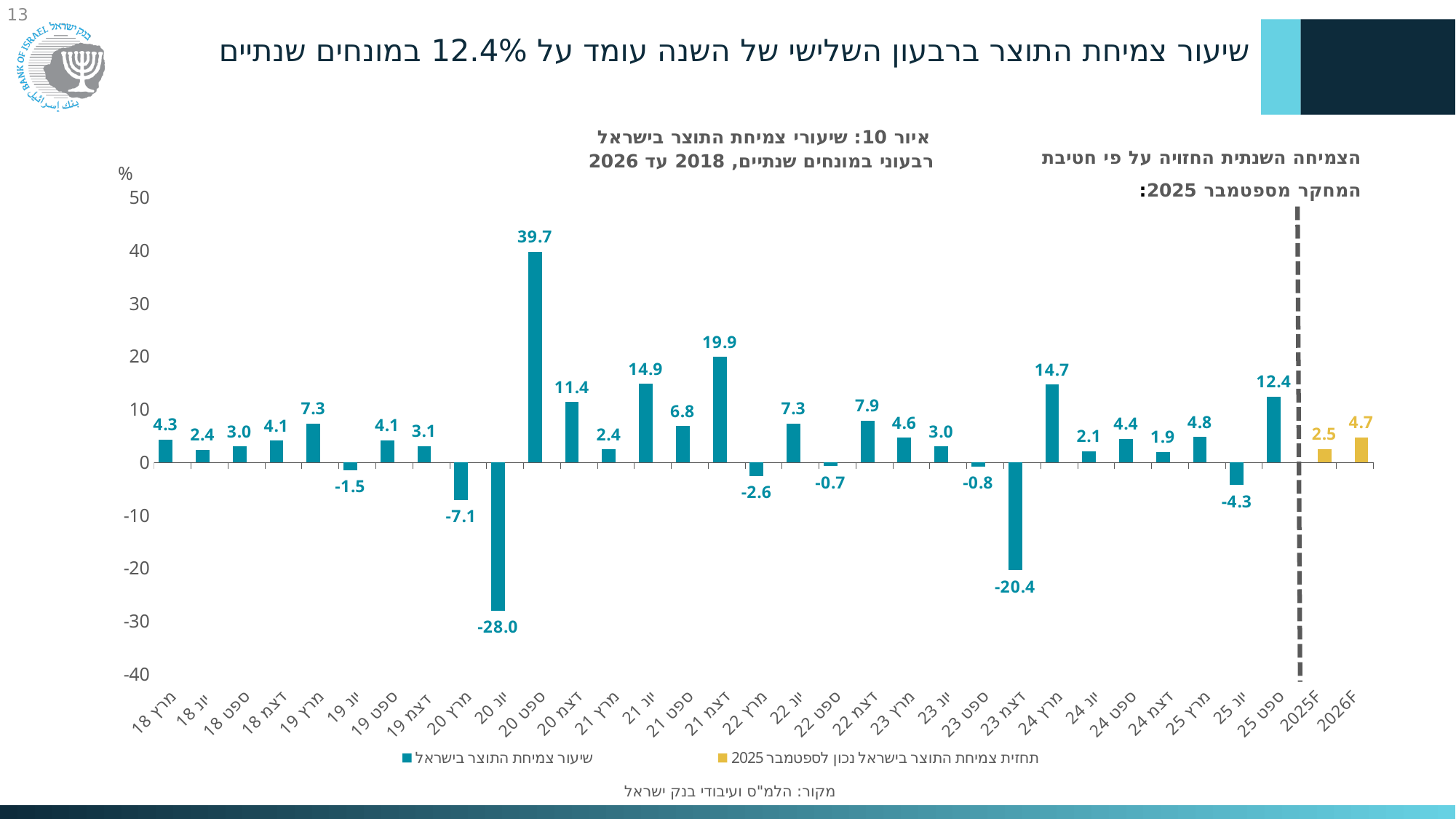
What is the difference between the values for דצמ 21 and ספט 21? 13.1 What is the forecast value for 2026F? 4.7 Which is larger, the value for מרץ 24 or the value for יונ 21? יונ 21 What is the value for יונ 20? -28.0 What is the value for ספט 25? 12.4 What kind of chart is shown? bar chart What is the value for ספט 20? 39.7 Which quarter has the lowest value? יונ 20 Which quarter has the highest value? ספט 20 What colour are the bars for 2025F and 2026F? yellow Is the value for דצמ 23 greater or less than -10? less How many series does the legend list? 2